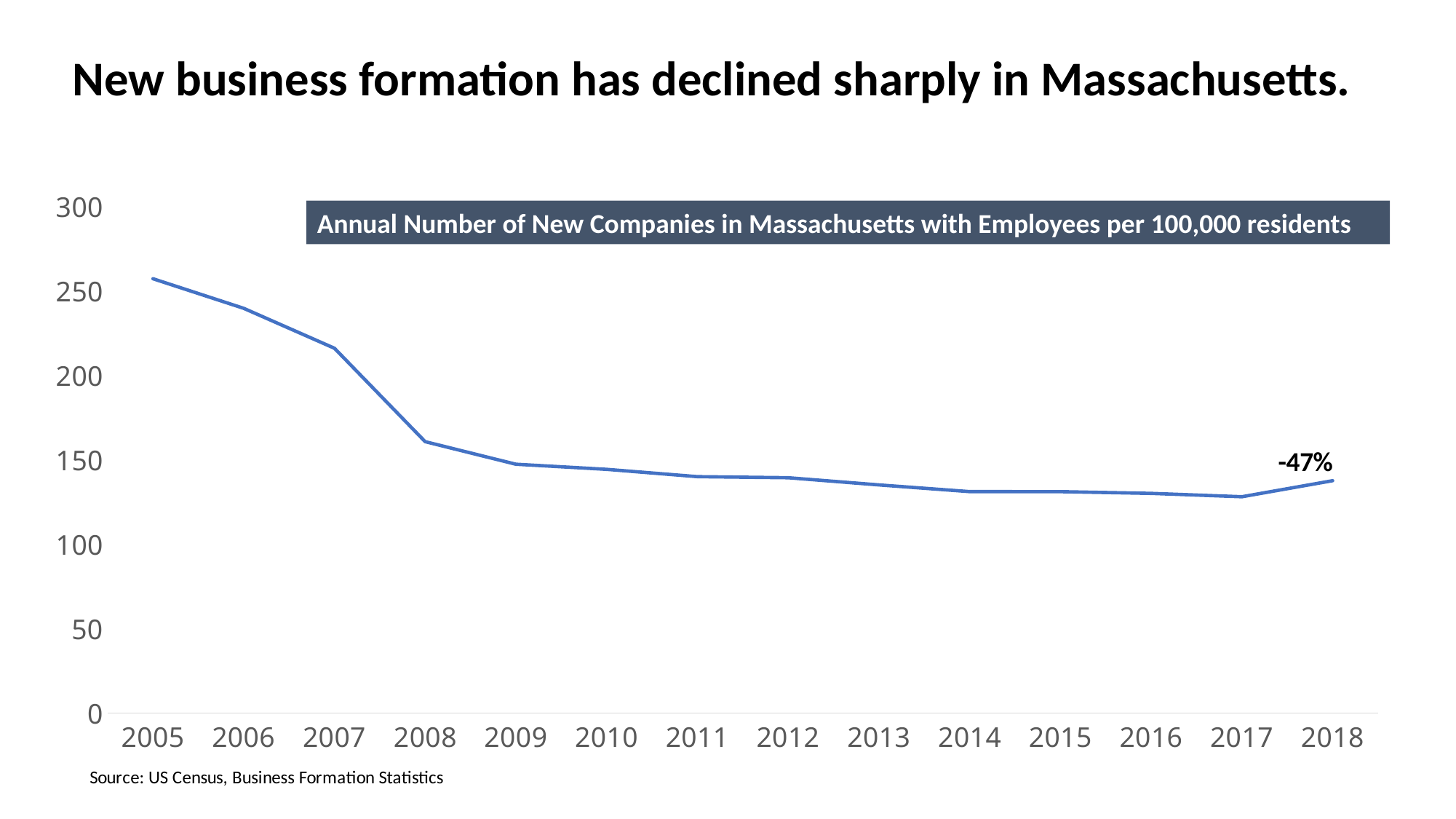
Is the value for 2008 greater or less than 150? greater How many years are plotted along the x axis? 14 What is the title of the chart? Annual Number of New Companies in Massachusetts with Employees per 100,000 residents Which year has the larger value, 2007 or 2008? 2007 Do the values generally rise or fall from 2005 to 2018? fall Which year has the highest value? 2005 Is the value for 2014 greater or less than 150? less What percentage change is annotated at the end of the line in 2018? -47% Is the value for 2005 greater or less than 250? greater Which year has the larger value, 2005 or 2018? 2005 What kind of chart is shown on the slide? line chart